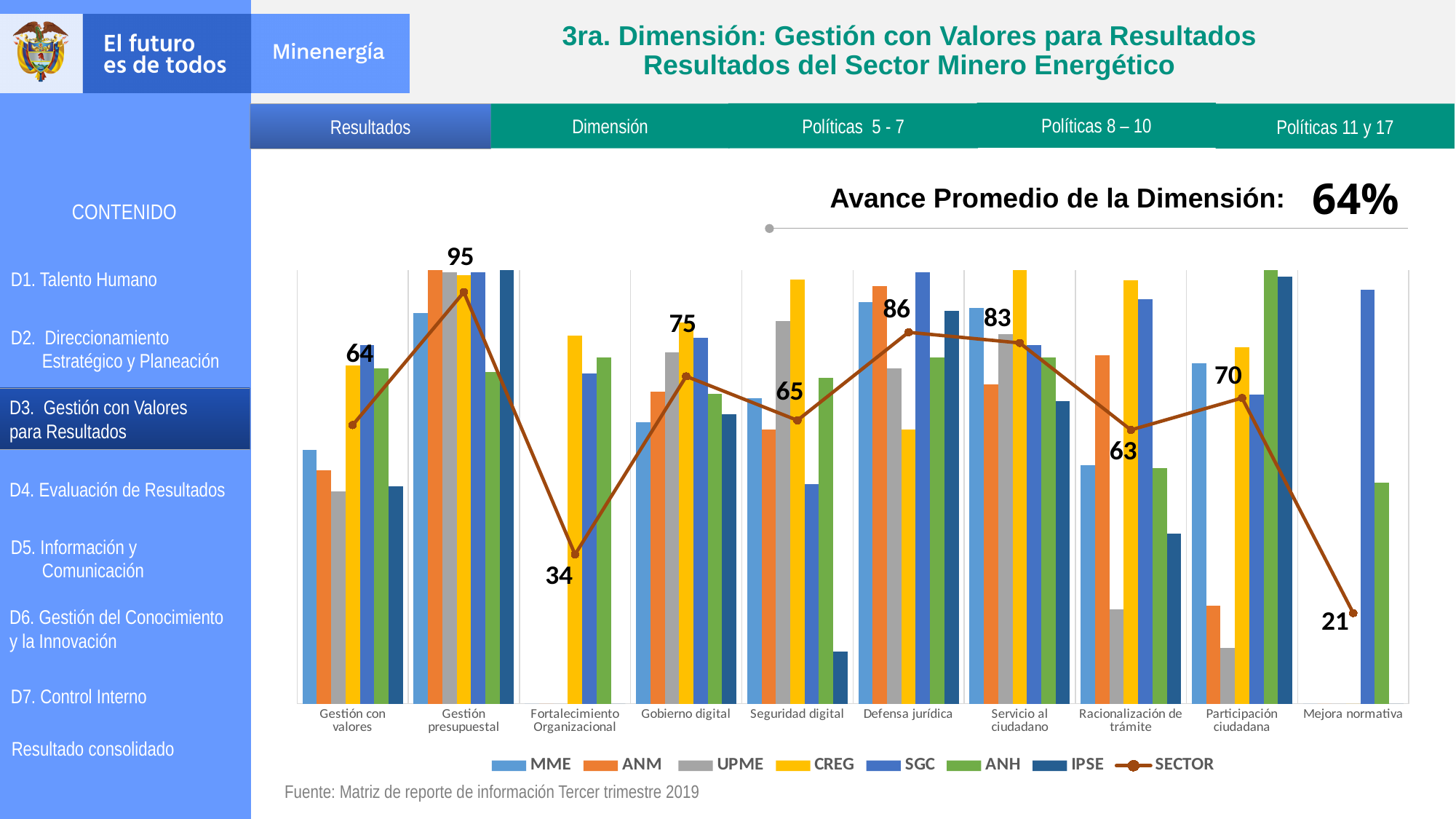
What is the SECTOR value for Mejora normativa? 21 What is the difference between the SECTOR values for Gestión presupuestal and Fortalecimiento Organizacional? 61 What is the SECTOR value for Gestión presupuestal? 95 Which category has the highest SECTOR value? Gestión presupuestal What is the SECTOR value for Servicio al ciudadano? 83 Which category has the lowest SECTOR value? Mejora normativa How many categories are shown on the x axis of the chart? 10 What is the difference between the SECTOR values for Defensa jurídica and Seguridad digital? 21 What kind of chart is shown on the slide? Bar chart with a line series How many series does the legend list? 8 Does the SECTOR line rise or fall from Participación ciudadana to Mejora normativa? Fall Which has a higher SECTOR value, Gobierno digital or Participación ciudadana? Gobierno digital